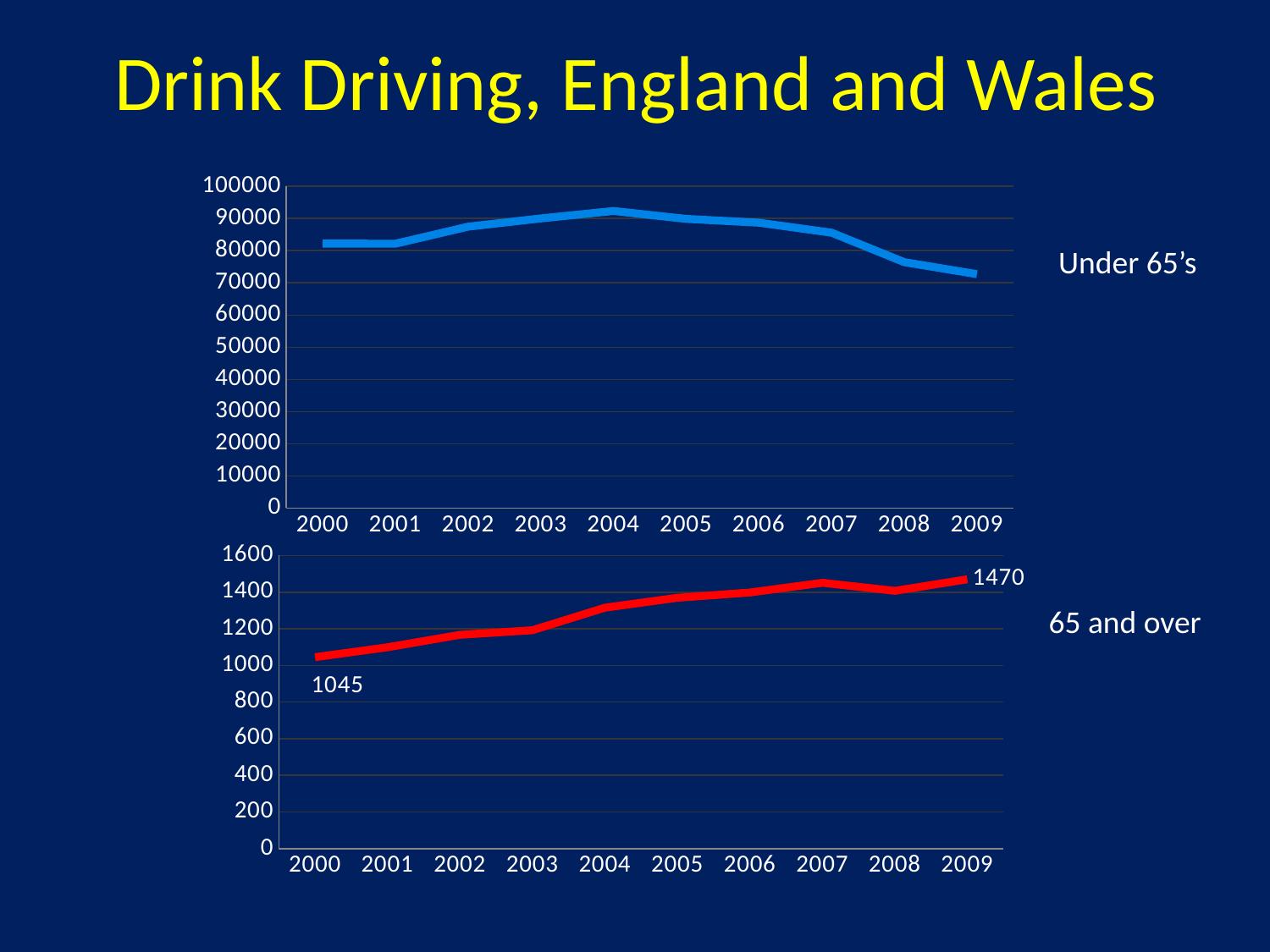
In the bottom chart (65 and over), do the values generally rise or fall from 2000 to 2009? rise What colour is the line in the bottom chart (65 and over)? red In the bottom chart (65 and over), what is the value for 2000? 1045 In the top chart (Under 65's), which year has the lowest value? 2009 In the top chart (Under 65's), which year has the highest value? 2004 In the bottom chart (65 and over), which year has the lowest value? 2000 What kind of chart is the top chart (Under 65's)? line chart In the top chart (Under 65's), is the value for 2009 greater or less than 80000? less In the bottom chart (65 and over), what is the value for 2009? 1470 In the top chart (Under 65's), which is larger, the value for 2002 or the value for 2008? 2002 How many years are plotted on the x axis of the top chart (Under 65's)? 10 In the bottom chart (65 and over), what is the difference between the 2009 value and the 2000 value? 425